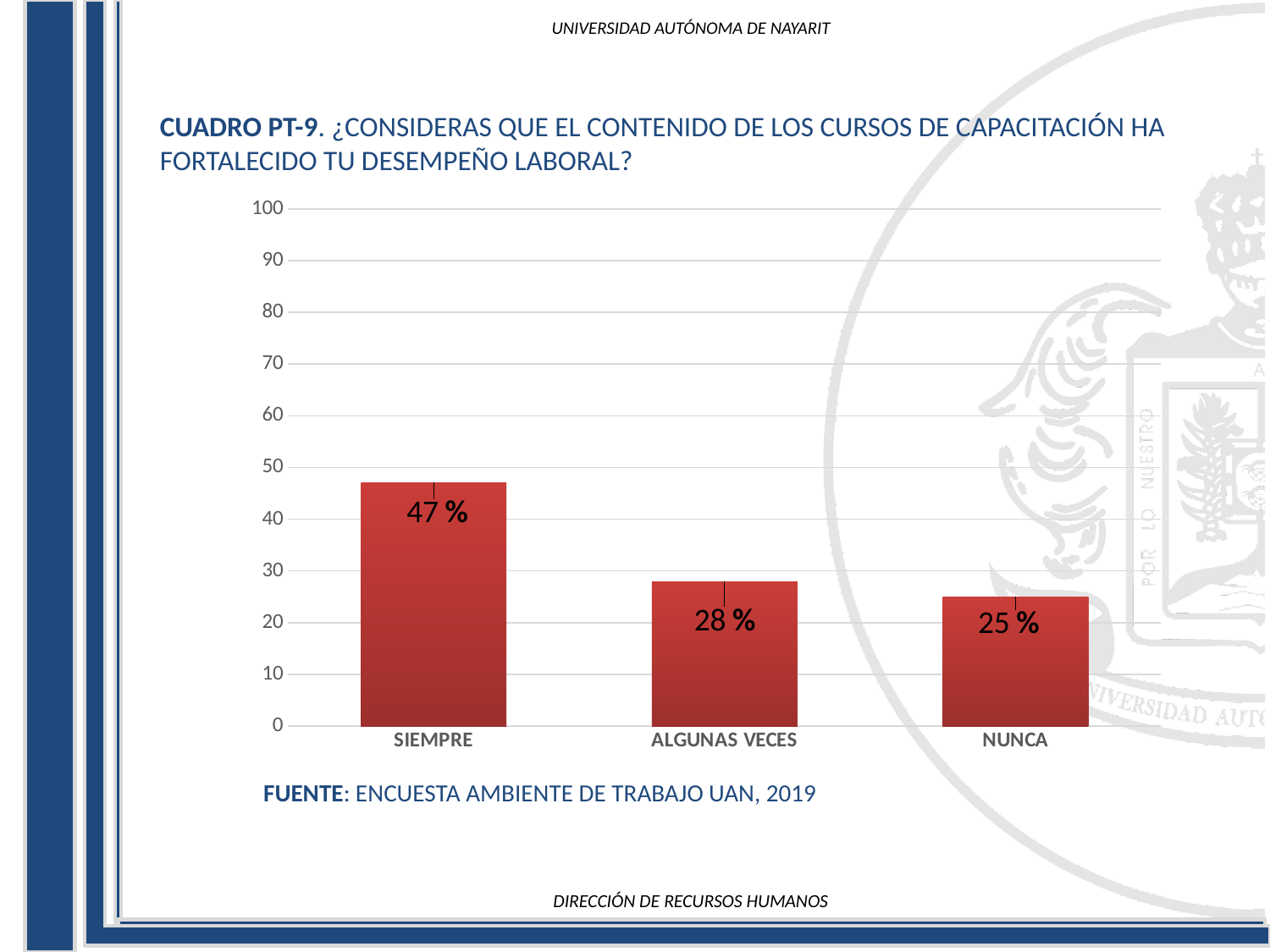
What kind of chart is shown on the slide? bar chart How many categories are shown on the x axis? 3 What is the difference between the values for ALGUNAS VECES and NUNCA? 3 % Which category has the lowest value? NUNCA What is the value for NUNCA? 25 % Is the value for SIEMPRE greater or less than 40? greater What is the value for ALGUNAS VECES? 28 % Which is larger, the value for SIEMPRE or the value for NUNCA? SIEMPRE Which category has the highest value? SIEMPRE What is the value for SIEMPRE? 47 % Do the values rise or fall from left to right along the x axis? fall What is the difference between the values for SIEMPRE and ALGUNAS VECES? 19 %